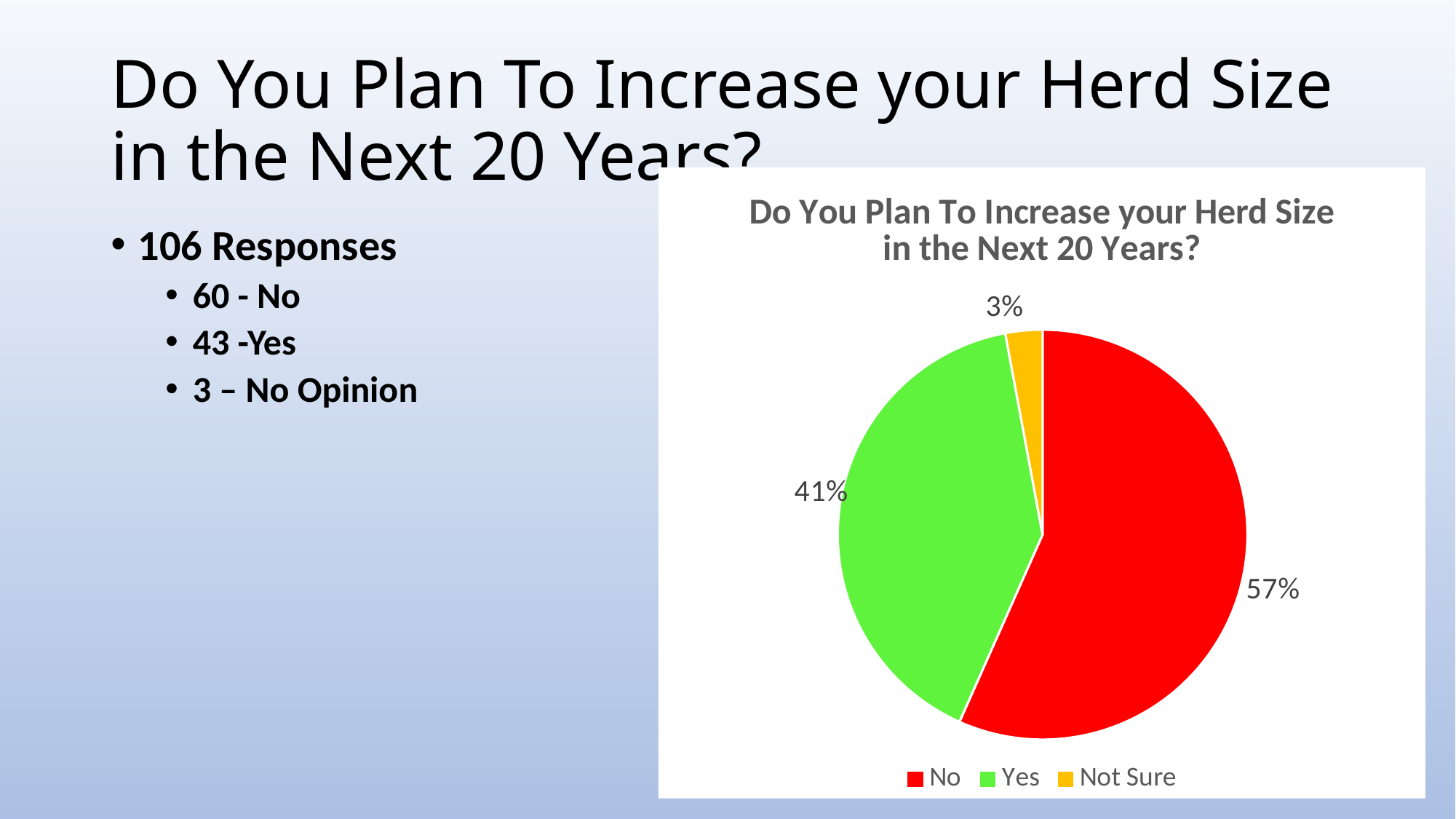
What percentage of the pie chart is the 'Yes' slice? 41% Which slice is larger, 'Yes' or 'Not Sure'? Yes Which category has the smallest slice of the pie chart? Not Sure What is the title of the chart? Do You Plan To Increase your Herd Size in the Next 20 Years? Which category has the largest slice of the pie chart? No What kind of chart is shown on the slide? Pie chart What is the difference in percentage points between the 'No' slice and the 'Yes' slice? 16 Is the 'No' slice greater or less than half of the pie? greater What percentage of the pie chart is the 'Not Sure' slice? 3% What percentage of the pie chart is the 'No' slice? 57% What colour is the 'Yes' slice in the pie chart? Green How many categories does the pie chart show? 3